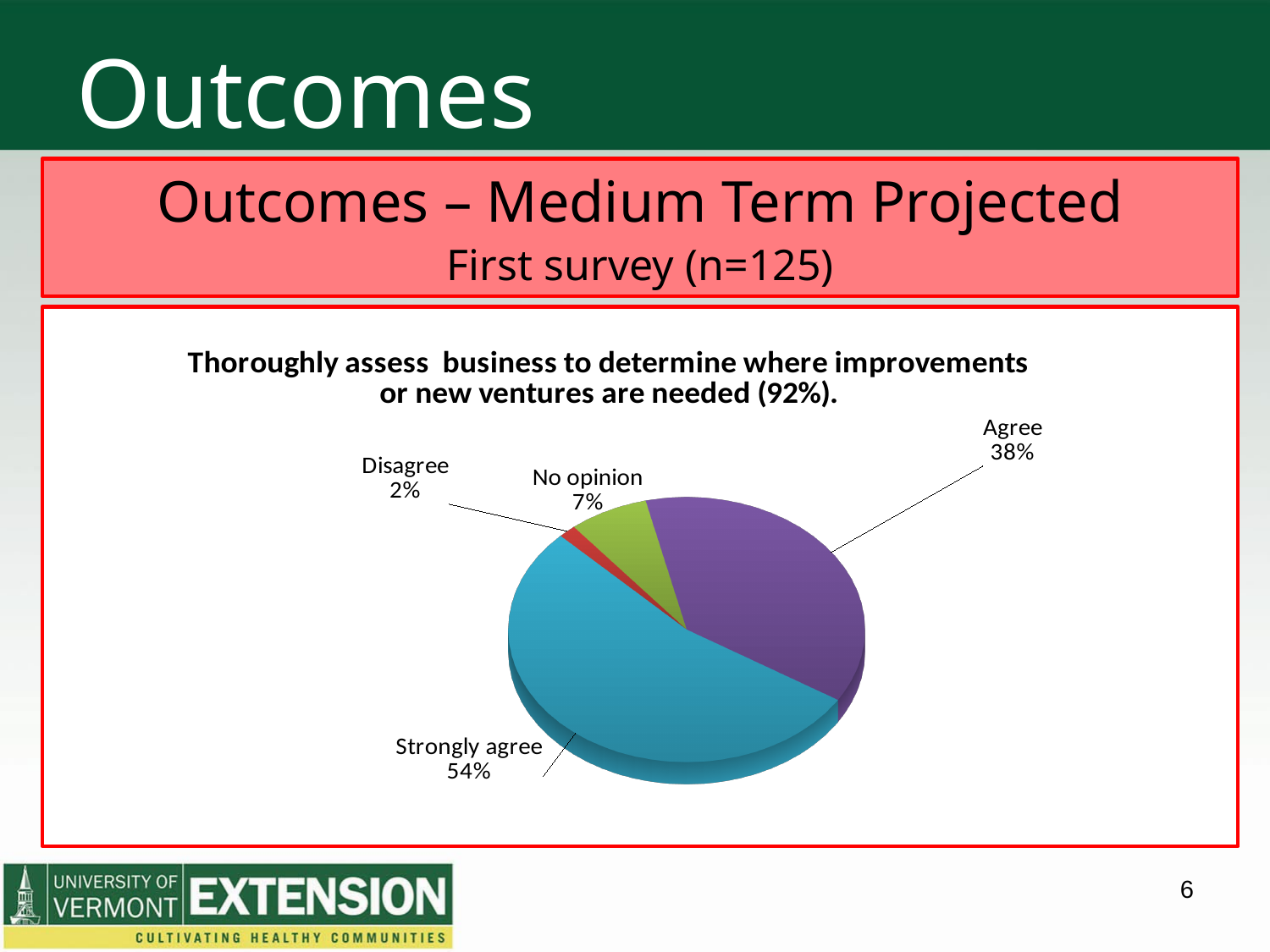
What percentage of respondents answered 'Agree'? 38% What percentage of respondents answered 'Disagree'? 2% Which response category has the smallest share of the pie? Disagree What percentage of respondents answered 'No opinion'? 7% Which response category has the largest share of the pie? Strongly agree Which is larger: the share for 'No opinion' or the share for 'Disagree'? No opinion What colour is the 'Strongly agree' slice? Blue How many slices does the pie chart have? 4 What is the combined share of 'Strongly agree' and 'Agree'? 92% What type of chart is shown on the slide? Pie chart What is the difference in percentage points between 'Strongly agree' and 'Agree'? 16 What percentage of respondents answered 'Strongly agree'? 54%